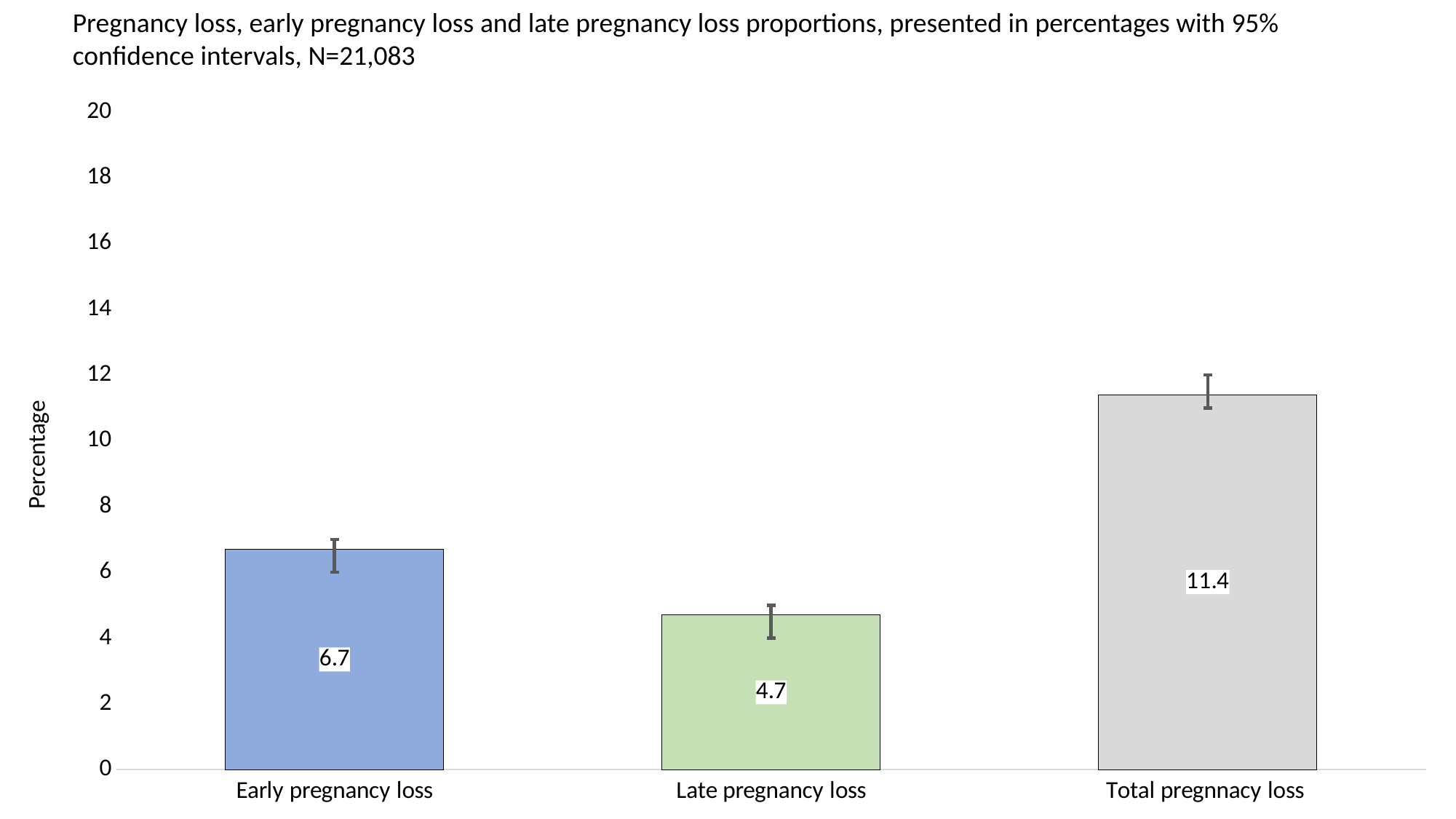
Which category has the lowest value? Late pregnancy loss Which category has the highest value? Total pregnnacy loss What kind of chart is shown on the slide? bar chart What is the value for Total pregnnacy loss? 11.4 What is the label of the y axis? Percentage What is the value for Late pregnancy loss? 4.7 Which is larger, the value for Early pregnancy loss or the value for Late pregnancy loss? Early pregnancy loss What is the difference between the values for Early pregnancy loss and Late pregnancy loss? 2.0 How many categories are shown on the x axis? 3 What is the difference between the values for Total pregnnacy loss and Early pregnancy loss? 4.7 Is the value for Total pregnnacy loss greater or less than 10? greater What is the value for Early pregnancy loss? 6.7